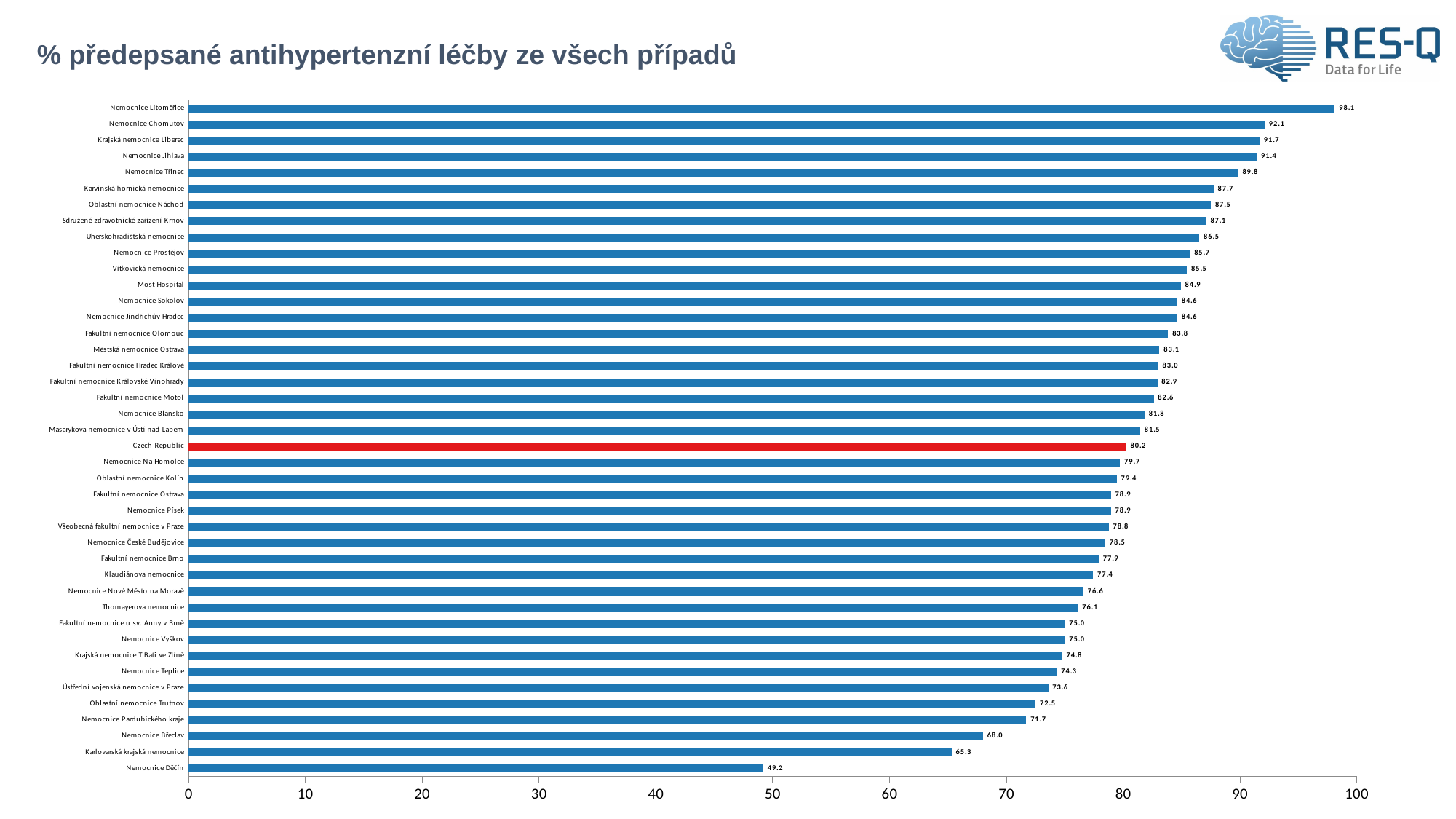
What is the value for Fakultní nemocnice Motol? 82.6 How many bars are shown in the chart? 42 What is the value for Nemocnice Litoměřice? 98.1 Is the value for Karlovarská krajská nemocnice greater or less than 70? less What is the value for Nemocnice Děčín? 49.2 What is the value for Czech Republic? 80.2 What is the difference between Nemocnice Litoměřice and Nemocnice Děčín? 48.9 Which is larger, the value for Nemocnice Chomutov or the value for Nemocnice Třinec? Nemocnice Chomutov What is the difference between Czech Republic and Nemocnice Břeclav? 12.2 Which hospital has the lowest value? Nemocnice Děčín Which hospital has the highest value? Nemocnice Litoměřice What type of chart is shown on the slide? bar chart